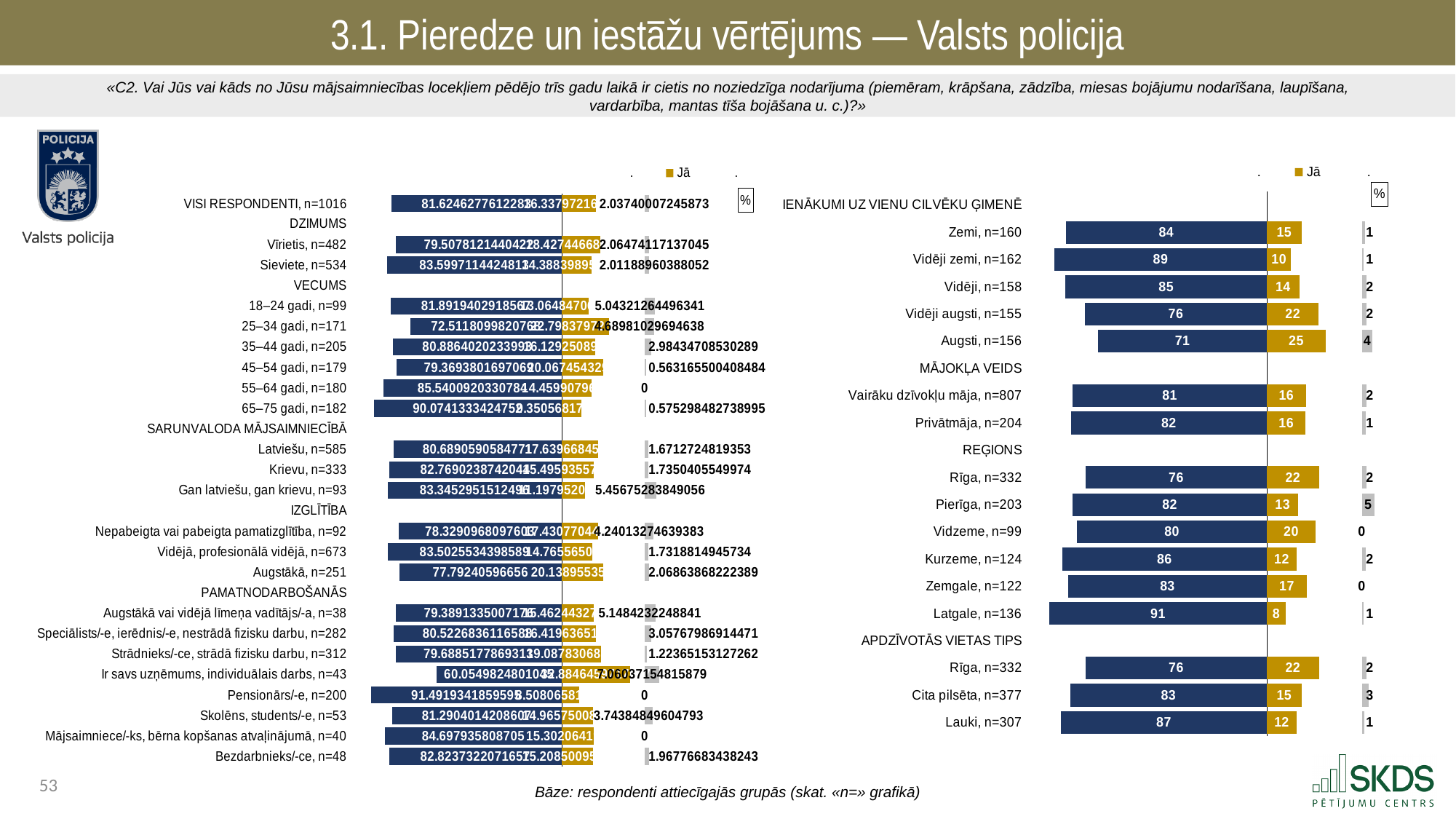
In the right-hand chart, which has the larger Jā value: Vidzeme, n=99 or Kurzeme, n=124? Vidzeme, n=99 In the right-hand chart (IENĀKUMI UZ VIENU CILVĒKU ĢIMENĒ), what is the Jā value for Augsti, n=156? 25 In the right-hand chart, what is the difference between the Jā value for Augsti, n=156 and the Jā value for Zemi, n=160? 10 In the right-hand chart, which of the income groups (Zemi to Augsti) has the lowest Jā value? Vidēji zemi, n=162 In the right-hand chart, which of the REĢIONS categories has the highest Jā value? Rīga, n=332 How many category bars are plotted in the right-hand chart? 16 What is the readable legend entry shown above the right-hand chart? Jā What kind of chart is the right-hand chart on the slide? bar chart What kind of chart is the left-hand chart (starting with VISI RESPONDENTI, n=1016)? bar chart In the right-hand chart, what is the Jā value for Lauki, n=307? 12 In the right-hand chart, what is the Jā value for Pierīga, n=203? 13 In the right-hand chart, what is the Jā value for Latgale, n=136? 8